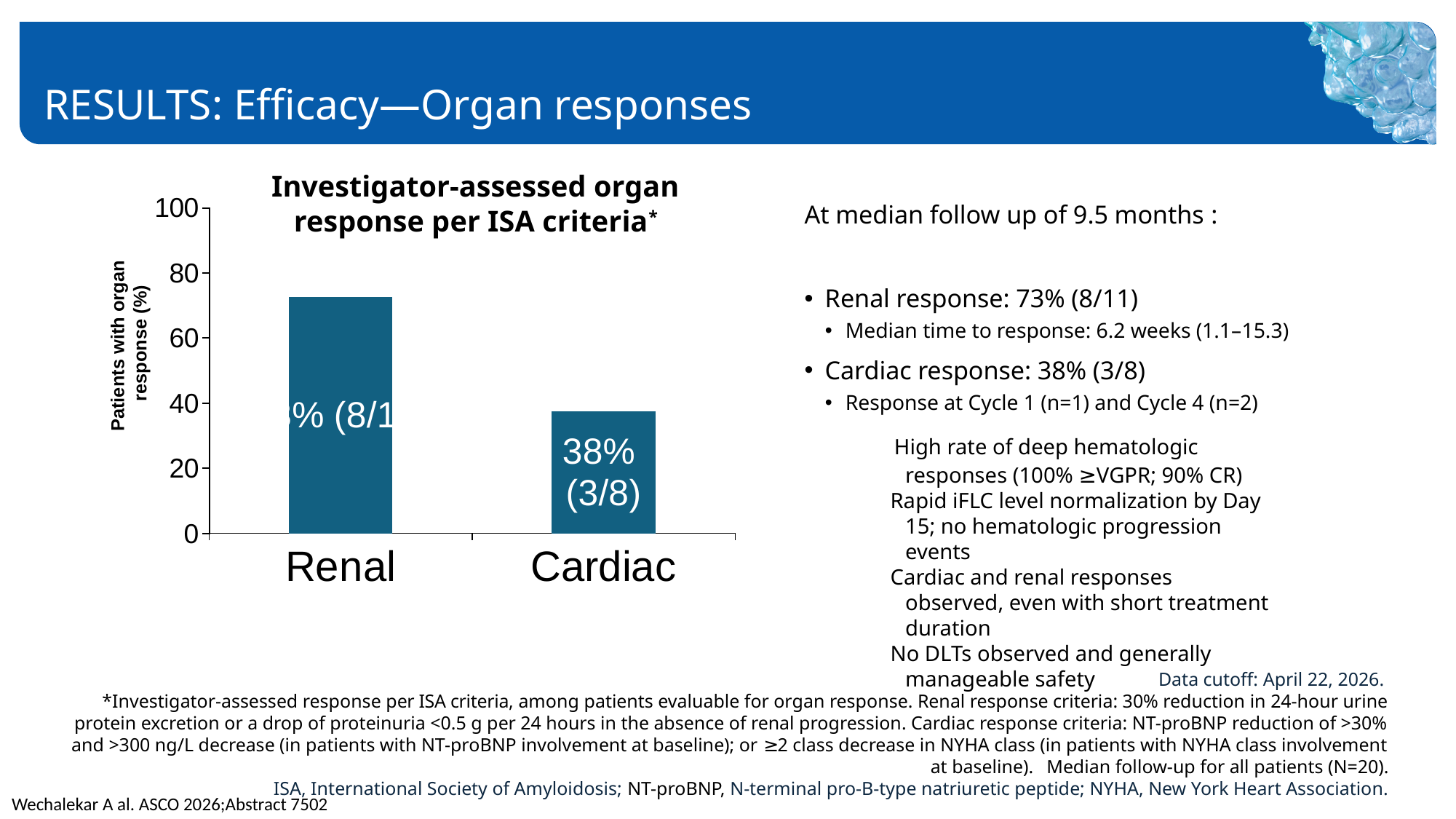
Is the value for Renal greater or less than 60? greater What is the organ response rate for Renal? 73% (8/11) Is the value for Cardiac greater or less than 40? less Which is larger, the Renal bar or the Cardiac bar? Renal How many categories are plotted in the chart? 2 What type of chart is shown on the slide? bar chart Which category has the highest bar in the chart? Renal What is the title of the chart? Investigator-assessed organ response per ISA criteria* What is the difference in percentage points between the Renal and Cardiac response rates? 35 Which category has the lowest bar in the chart? Cardiac What is the label of the y-axis of the chart? Patients with organ response (%) What is the value shown for Cardiac in the chart? 38% (3/8)